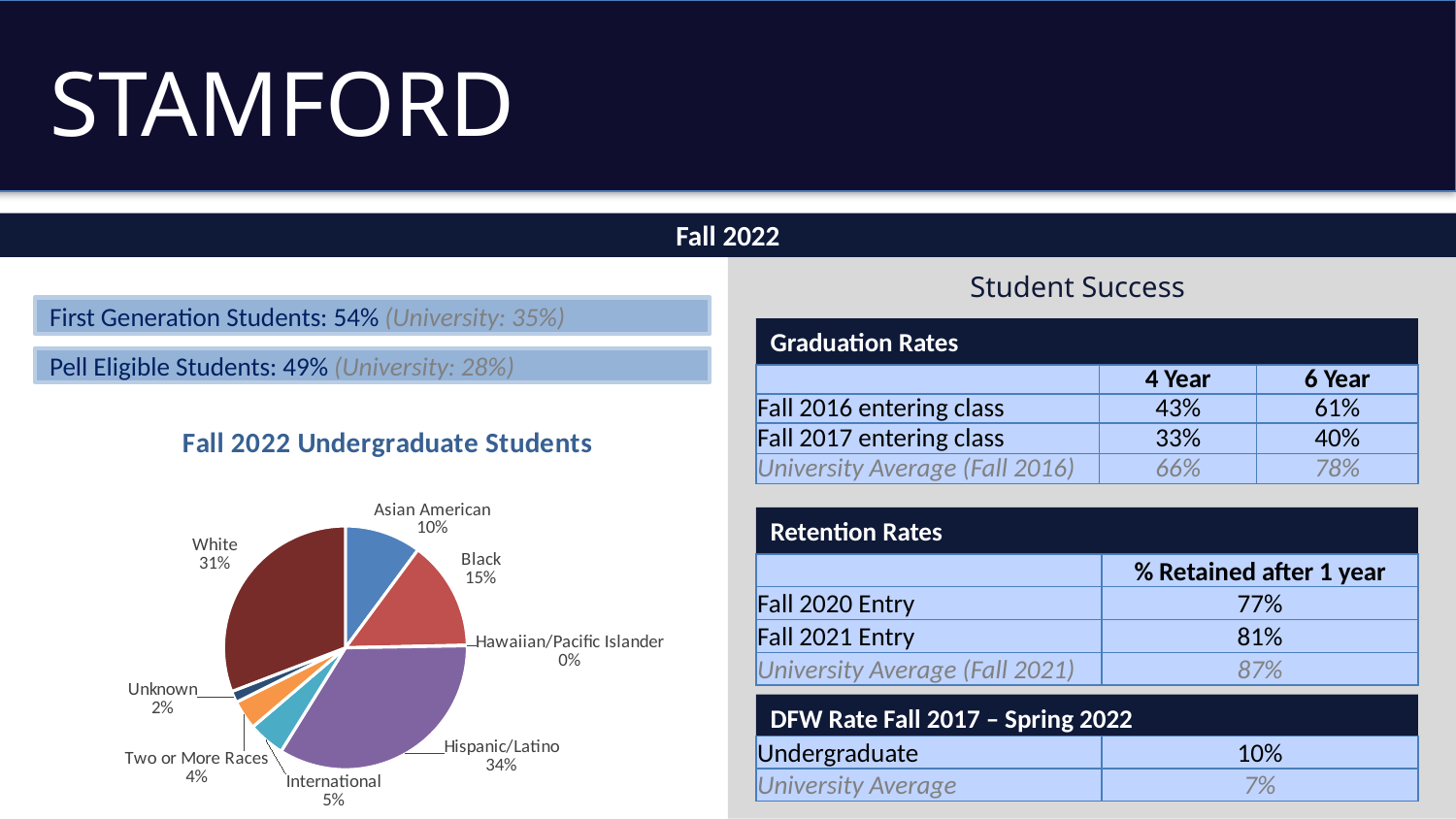
What is the difference between the Black and Asian American shares in the pie chart? 5% What share of Fall 2022 undergraduate students is International? 5% What type of chart is shown on the slide? Pie chart What share of Fall 2022 undergraduate students is White? 31% Which is larger in the pie chart, the White share or the Black share? White What is the title of the pie chart? Fall 2022 Undergraduate Students Which category has the smallest slice in the pie chart? Hawaiian/Pacific Islander What share of Fall 2022 undergraduate students is Hispanic/Latino? 34% What share of Fall 2022 undergraduate students is Asian American? 10% Which category has the largest slice in the pie chart? Hispanic/Latino What is the difference between the Hispanic/Latino and White shares in the pie chart? 3% How many categories are shown in the pie chart? 8